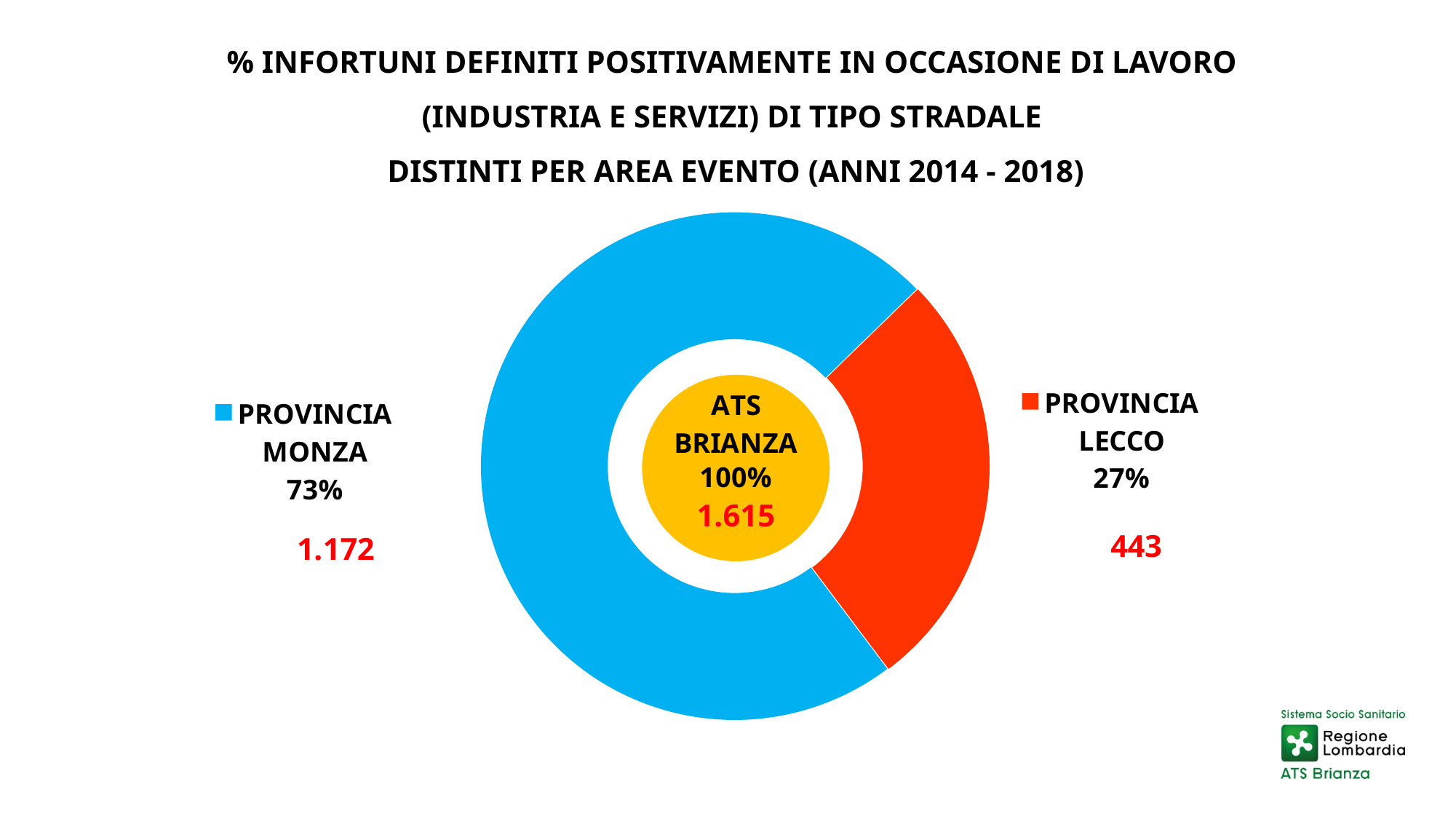
What percentage share does PROVINCIA LECCO have in the chart? 27% Which area has the largest share of the chart? PROVINCIA MONZA What percentage share does PROVINCIA MONZA have in the chart? 73% What kind of chart is shown on the slide? Pie chart (doughnut) How many areas (slices) are shown in the chart? 2 What is the count shown for PROVINCIA MONZA? 1.172 What is the count shown for PROVINCIA LECCO? 443 Which area has the smallest share of the chart? PROVINCIA LECCO Which is larger, the count for PROVINCIA MONZA or for PROVINCIA LECCO? PROVINCIA MONZA What total is shown in the centre of the chart for ATS BRIANZA? 1.615 What colour is the slice for PROVINCIA LECCO? Red What is the difference in percentage points between PROVINCIA MONZA and PROVINCIA LECCO? 46